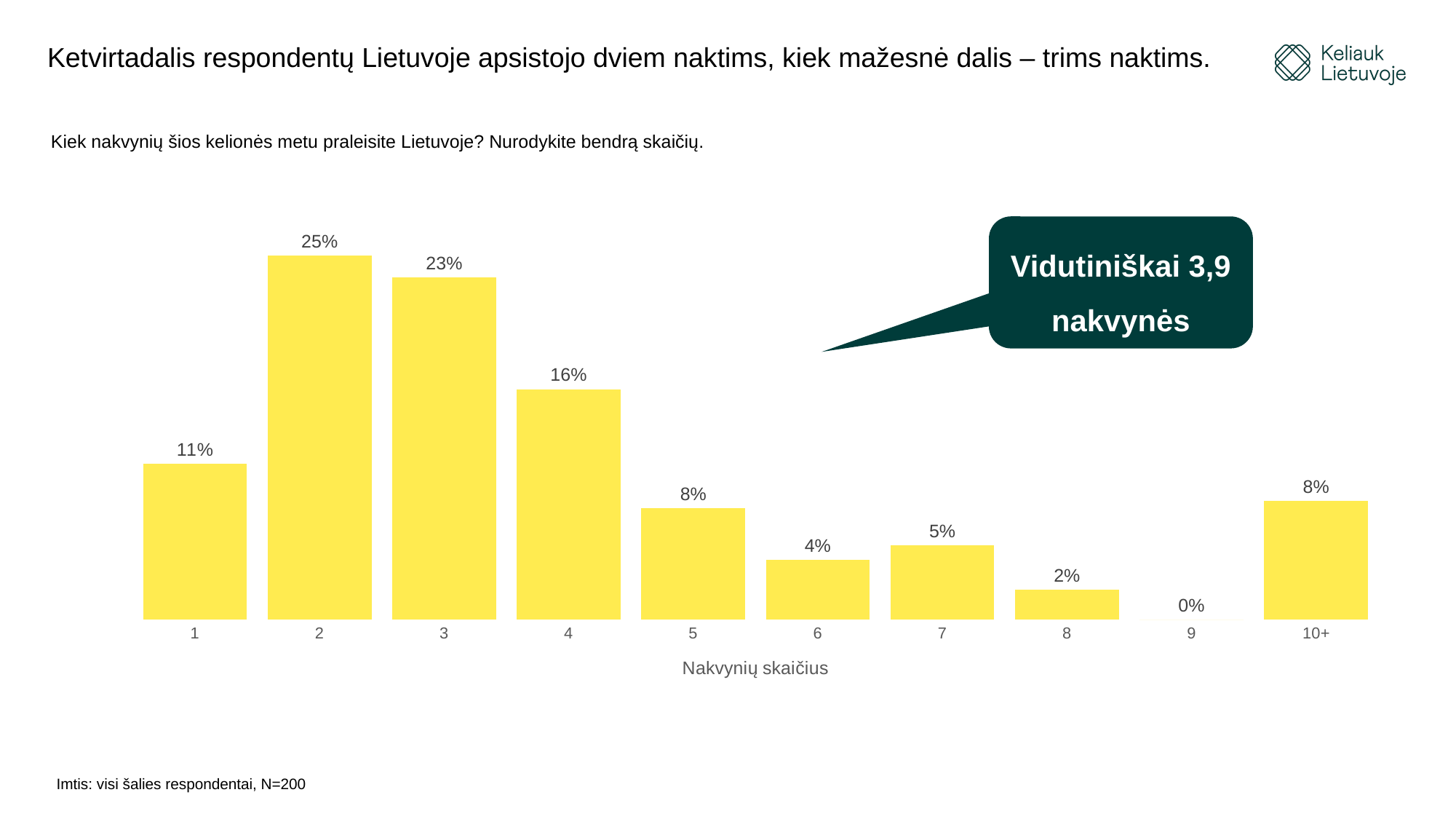
What percentage of respondents stayed 2 nights? 25% What is the difference between the values for 1 night and 5 nights? 3% Which category has the lowest value on the chart? 9 What type of chart is shown on the slide? Bar chart How many categories are shown on the x axis? 10 Which number of nights has the highest share of respondents? 2 What average number of nights is stated in the callout on the chart? 3,9 Do the values generally rise or fall from 2 nights to 9 nights? Fall Which is larger, the value for 6 nights or the value for 7 nights? 7 nights What percentage is shown for the 10+ nights category? 8% What is the value shown for 4 nights? 16% What is the difference between the values for 2 nights and 3 nights? 2%